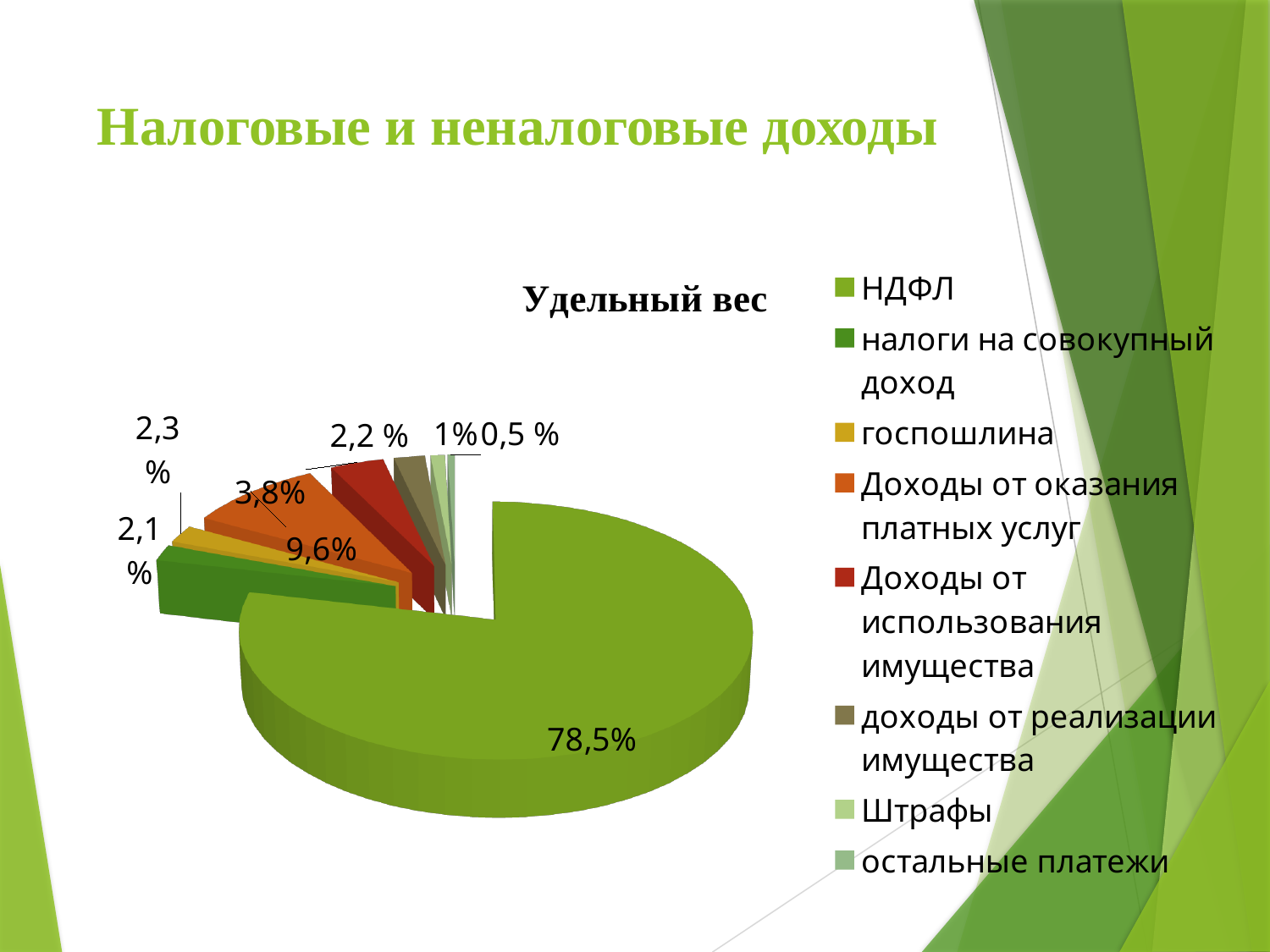
What is the value shown for налоги на совокупный доход? 2,1 % Which is larger: the share of налоги на совокупный доход or the share of Доходы от оказания платных услуг? Доходы от оказания платных услуг What is the value shown for Доходы от оказания платных услуг? 9,6% What colour is the slice for НДФЛ? light green What is the difference between the shares of НДФЛ and налоги на совокупный доход? 76,4% What is the value shown for Доходы от использования имущества? 3,8% Which category has the largest share of the pie? НДФЛ What kind of chart is shown on the slide? pie chart What is the title of the chart? Удельный вес What is the value shown for доходы от реализации имущества? 2,2 % What share of the pie does НДФЛ have? 78,5% How many entries does the chart legend list? 8